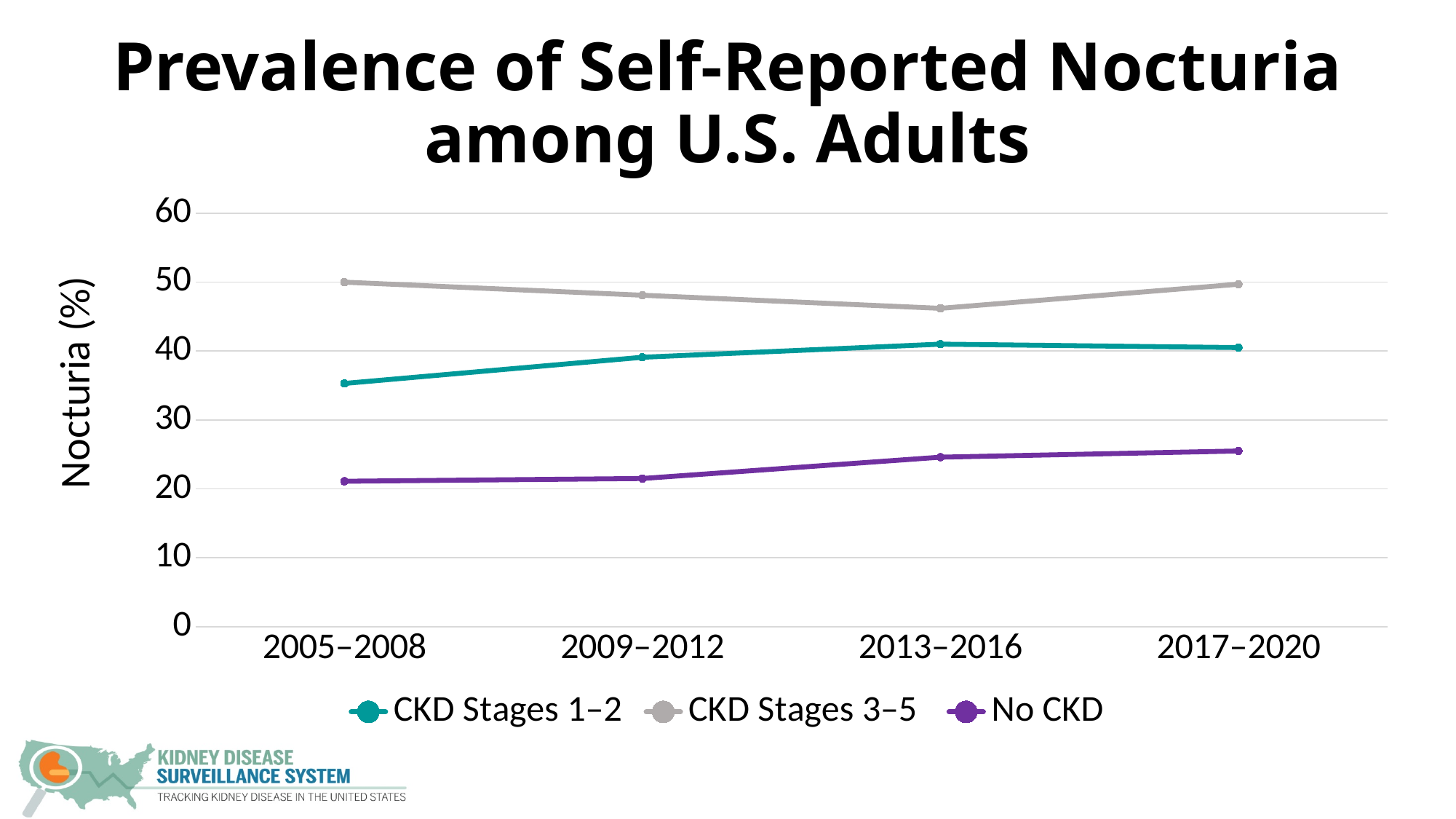
What kind of chart is shown on the slide? Line chart Which series has the highest nocturia prevalence across all periods? CKD Stages 3–5 Does the No CKD line rise or fall from 2005–2008 to 2017–2020? Rise Is the value for CKD Stages 1–2 in 2005–2008 greater or less than 40? less Is the value for No CKD in 2017–2020 greater or less than 30? less In which period is the value for CKD Stages 1–2 lowest? 2005–2008 In which period is the value for CKD Stages 3–5 lowest? 2013–2016 How many time periods are shown on the x axis? 4 How many series does the legend list? 3 Is the value for CKD Stages 3–5 in 2013–2016 greater or less than 50? less Which series has the lowest nocturia prevalence across all periods? No CKD In 2009–2012, which is larger: the value for CKD Stages 1–2 or the value for No CKD? CKD Stages 1–2